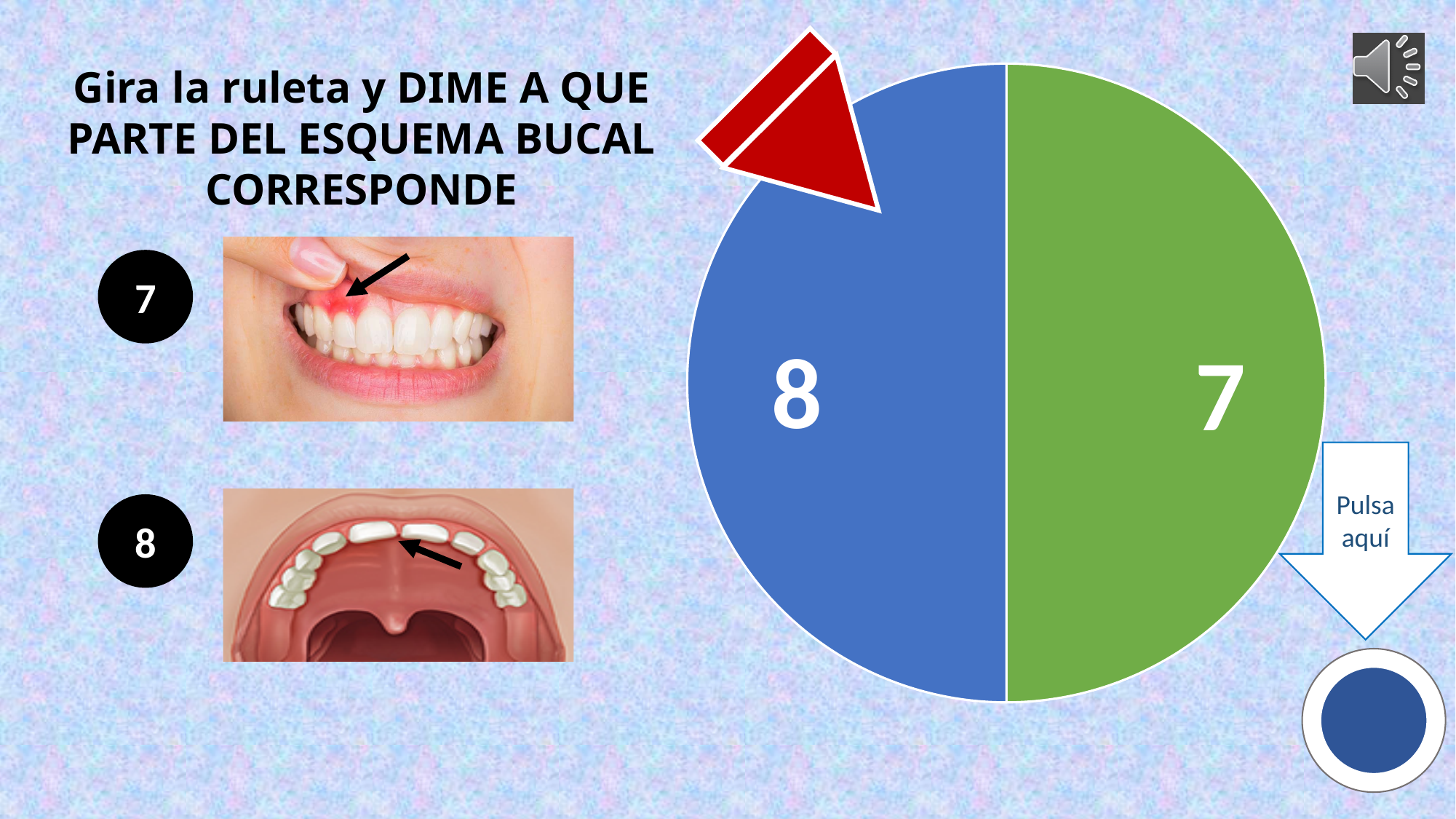
What number is printed on the blue slice of the pie chart? 8 What kind of chart is the roulette wheel on the right side of the slide? pie chart How many slices does the pie chart on the right have? 2 What number is printed on the green slice of the pie chart? 7 Which slice of the pie chart is the red pointer pointing at? 8 What colour is the slice labelled 7 in the pie chart? green What colour is the slice labelled 8 in the pie chart? blue